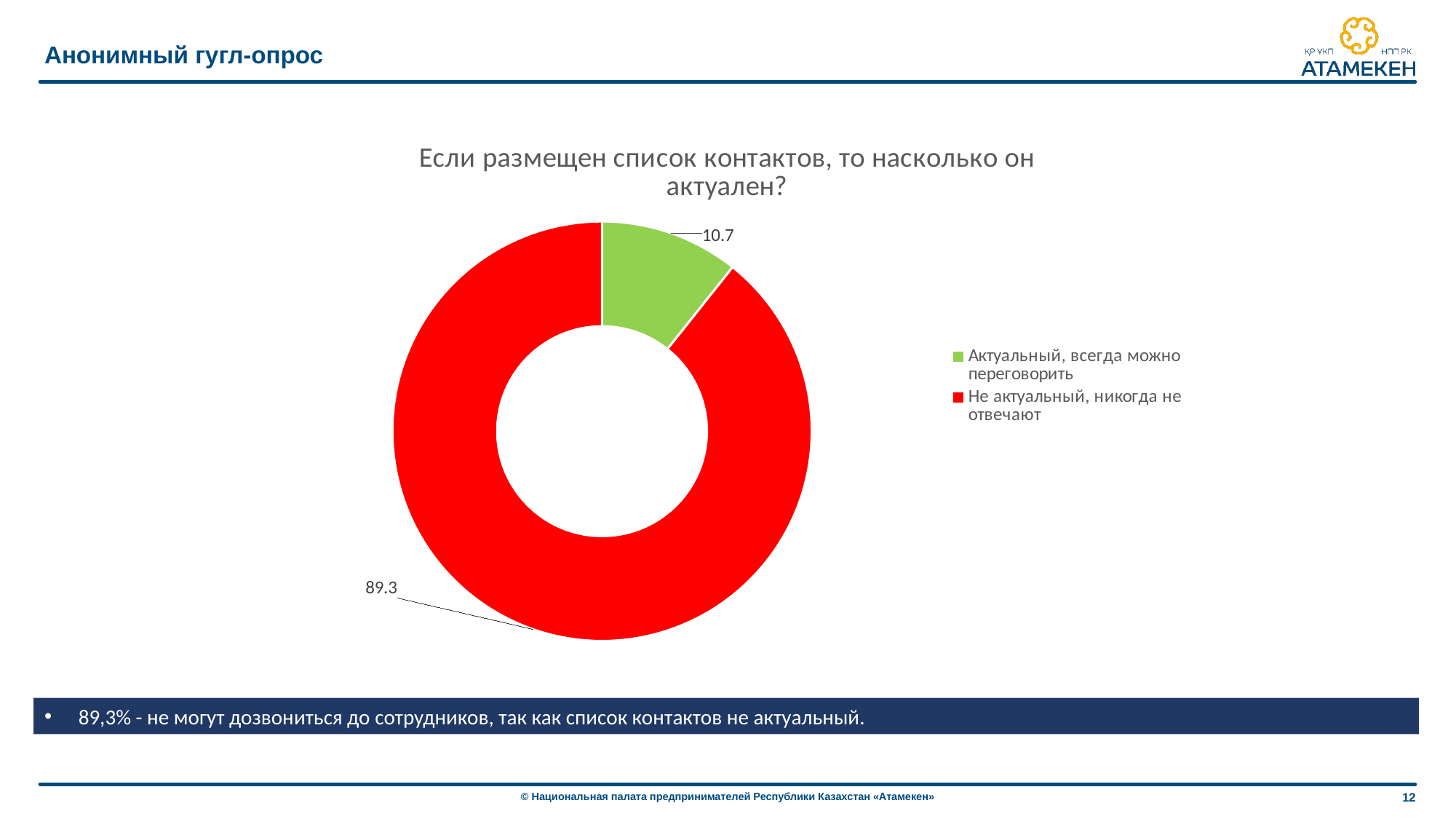
How many categories does the chart show? 2 What is the title of the chart? Если размещен список контактов, то насколько он актуален? Which is larger: the slice for 'Актуальный, всегда можно переговорить' or the slice for 'Не актуальный, никогда не отвечают'? Не актуальный, никогда не отвечают Which category has the smallest slice in the chart? Актуальный, всегда можно переговорить What is the total of the two values shown in the chart? 100 What value is shown for the slice 'Актуальный, всегда можно переговорить'? 10.7 What colour is the slice for 'Не актуальный, никогда не отвечают'? Red What value is shown for the slice 'Не актуальный, никогда не отвечают'? 89.3 Which category has the largest slice in the chart? Не актуальный, никогда не отвечают What kind of chart is shown on the slide? Doughnut (pie) chart What is the difference between the values for 'Не актуальный, никогда не отвечают' and 'Актуальный, всегда можно переговорить'? 78.6